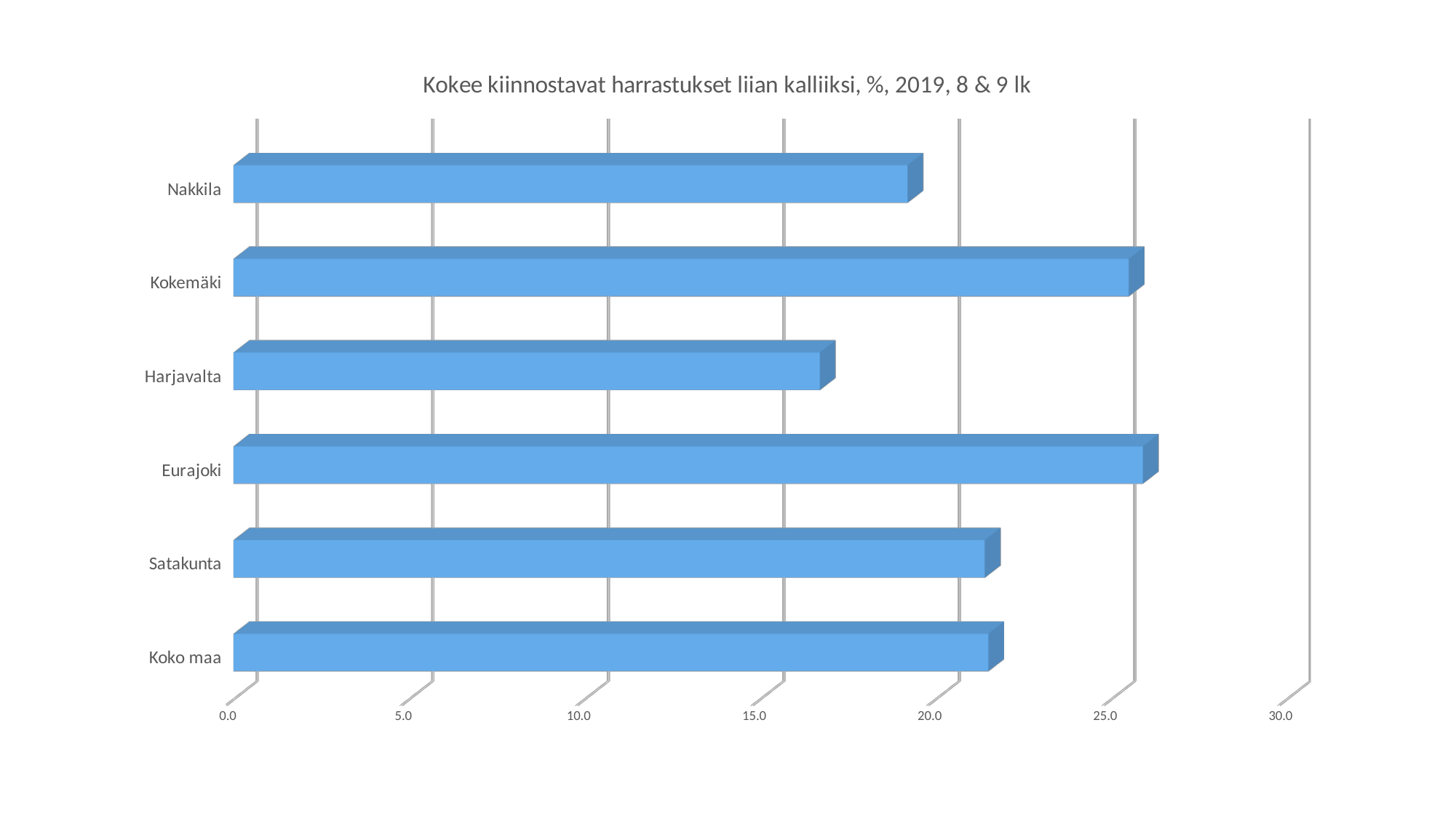
Is the value for Harjavalta greater or less than 15.0? greater What kind of chart is shown on the slide? bar chart Is the value for Eurajoki greater or less than 25.0? greater Which is larger, the value for Kokemäki or the value for Satakunta? Kokemäki Which category has the lowest value? Harjavalta Which is larger, the value for Nakkila or the value for Harjavalta? Nakkila How many categories are plotted in the chart? 6 Is the value for Koko maa greater or less than 20.0? greater What is the title of the chart? Kokee kiinnostavat harrastukset liian kalliiksi, %, 2019, 8 & 9 lk